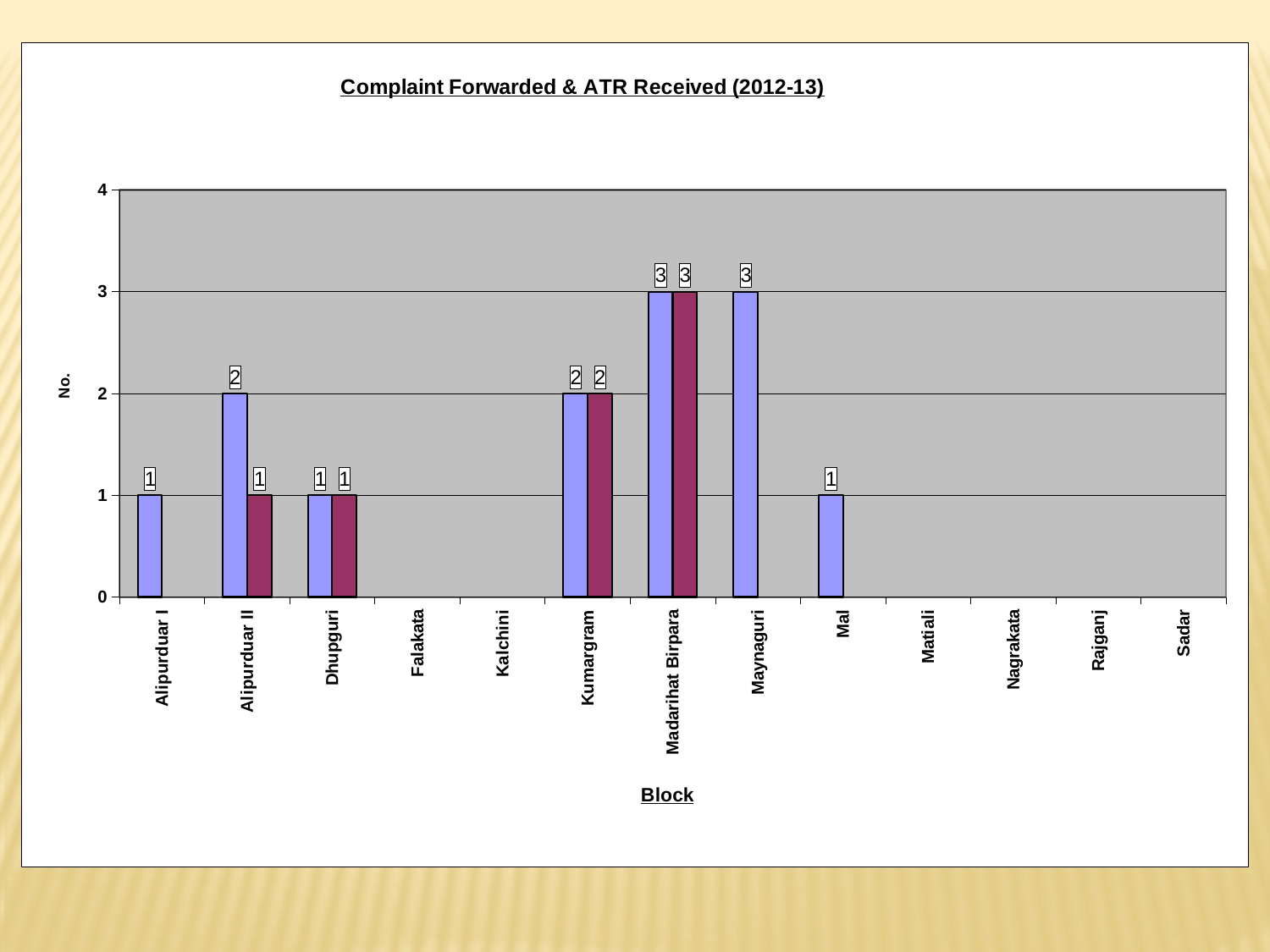
What is the value of the maroon bar for Madarihat Birpara? 3 Which block has the highest maroon bar? Madarihat Birpara What is the value of the blue bar for Maynaguri? 3 How many blocks are listed along the x axis of the chart? 13 Is the blue bar for Madarihat Birpara greater or less than 2? greater Which is larger for Kumargram, the blue bar or the maroon bar? They are equal (both 2) What is the value of the blue bar for Mal? 1 What is the value of the blue bar for Alipurduar II? 2 What type of chart is shown on the slide? bar chart What is the label of the x axis? Block What is the difference between the blue bar and the maroon bar for Alipurduar II? 1 What is the title of the chart? Complaint Forwarded & ATR Received (2012-13)